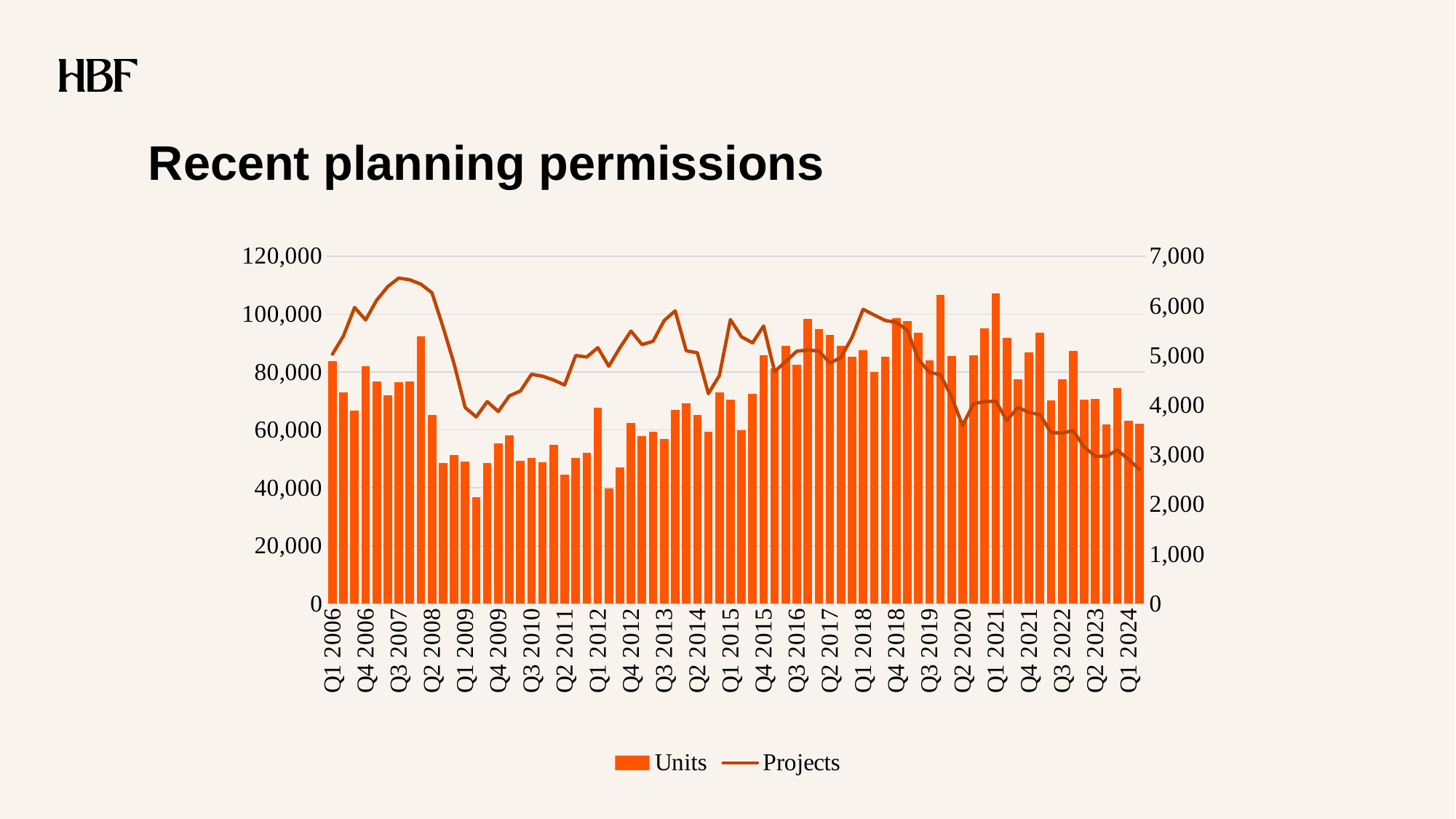
Is the Units value for Q1 2009 greater or less than 40,000? greater What is the title of the chart? Recent planning permissions Is the Units value for Q3 2019 greater or less than 100,000? less Is the Projects value for Q3 2007 greater or less than 6,000? greater Does the Projects line rise or fall between Q3 2019 and Q1 2024? Fall What kind of chart is shown on the slide? A combined bar and line chart Which is larger, the Units value for Q1 2009 or for Q1 2021? Q1 2021 Which series is plotted as a line? Projects How many series does the legend list? 2